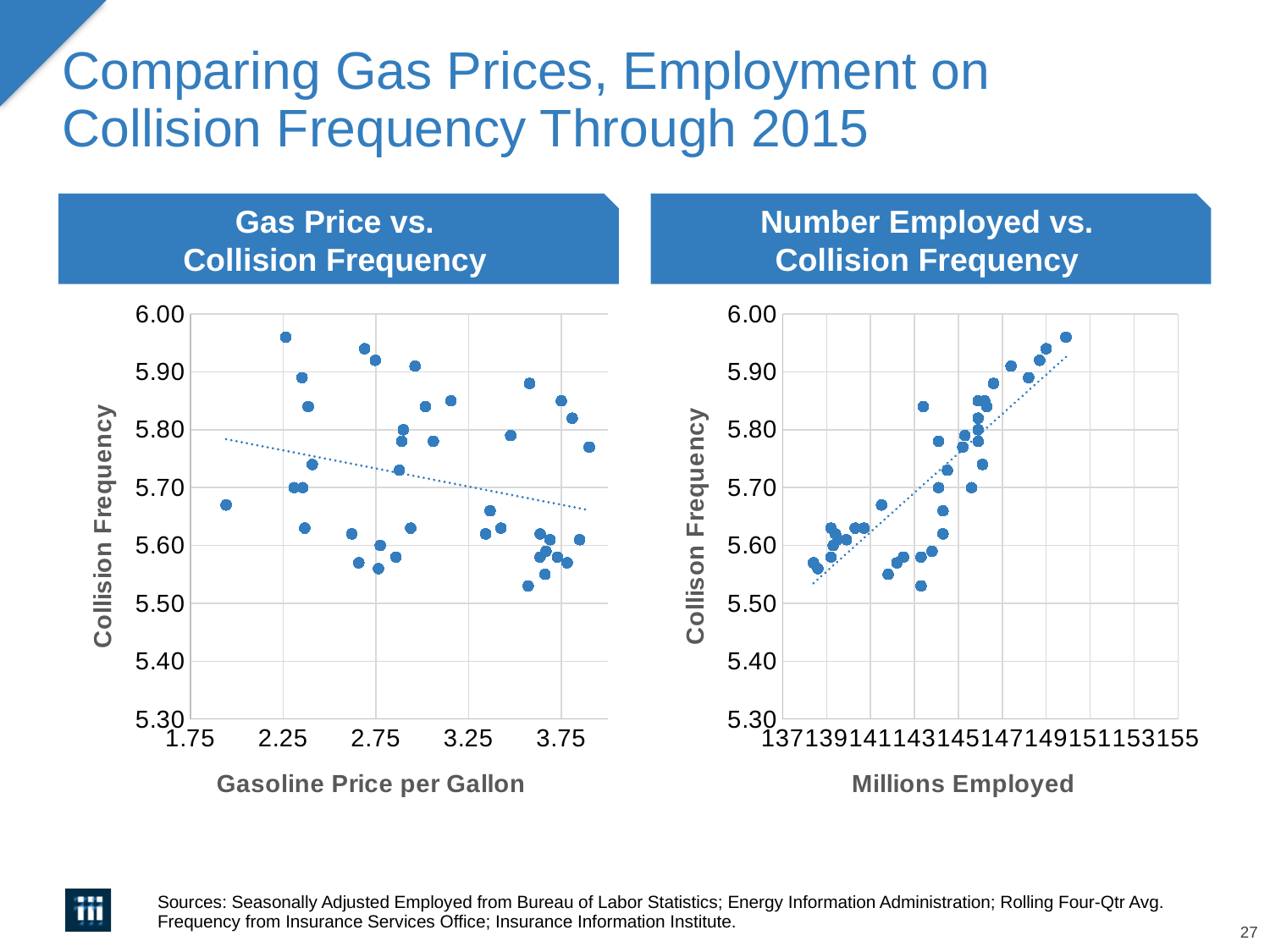
What kind of chart is the "Gas Price vs. Collision Frequency" chart? scatter chart What kind of chart is the "Number Employed vs. Collision Frequency" chart? scatter chart In the "Gas Price vs. Collision Frequency" chart, does the dotted trend line rise or fall as gasoline price increases? fall In the "Gas Price vs. Collision Frequency" chart, is the collision frequency of the leftmost point (gas price just under 2.00) greater or less than 5.60? greater In the "Number Employed vs. Collision Frequency" chart, is the collision frequency of the point at the highest employment level (around 150 million) greater or less than 5.90? greater In the "Number Employed vs. Collision Frequency" chart, is the lowest plotted collision frequency greater or less than 5.60? less What is the x-axis label of the "Number Employed vs. Collision Frequency" chart? Millions Employed What is the x-axis label of the "Gas Price vs. Collision Frequency" chart? Gasoline Price per Gallon In the "Number Employed vs. Collision Frequency" chart, does the dotted trend line rise or fall as millions employed increases? rise